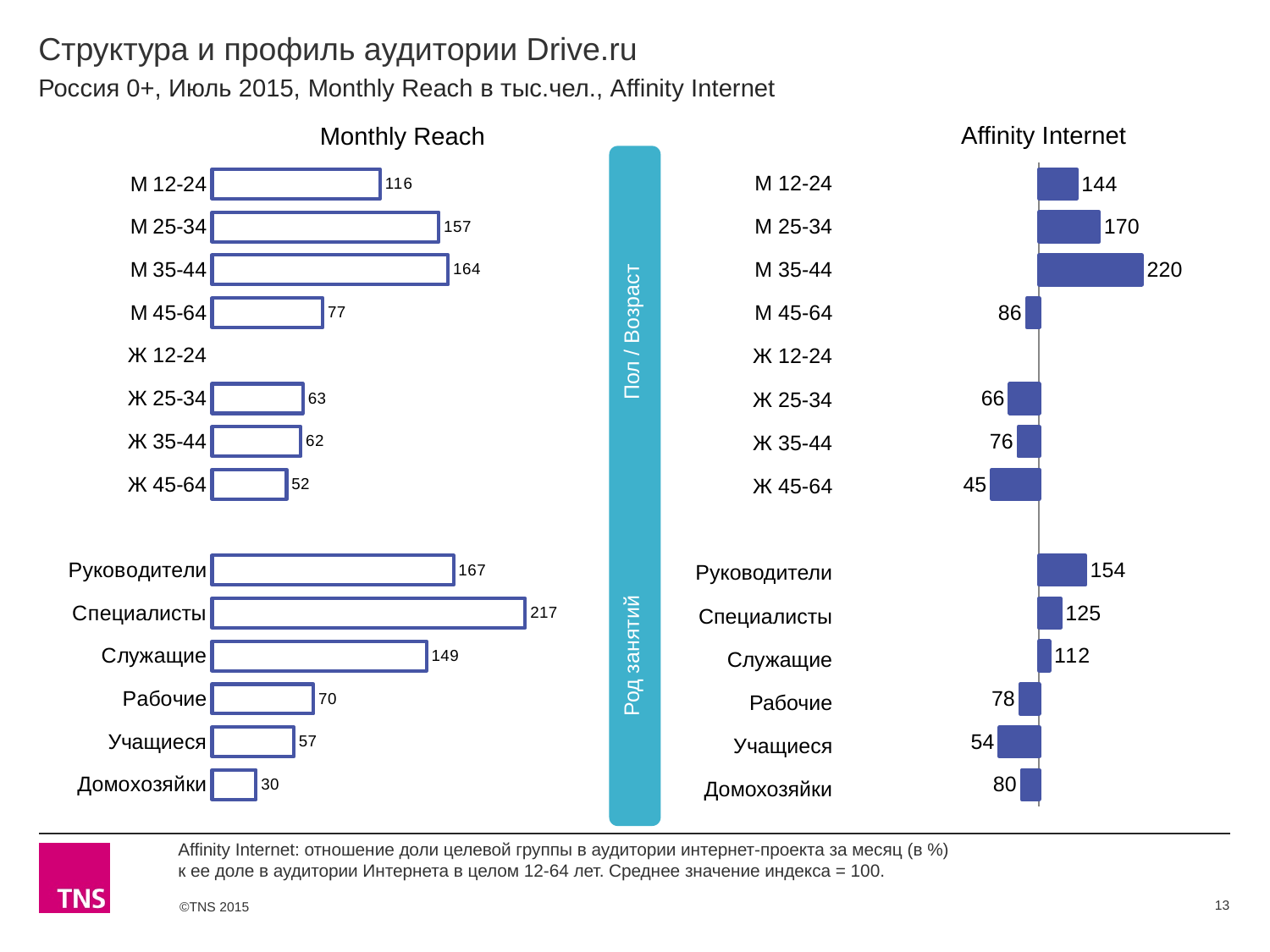
In the Monthly Reach chart, what is the difference between the values for М 25-34 and М 45-64? 80 In the Monthly Reach chart, what is the value for М 35-44? 164 In the Monthly Reach chart, which category has the lowest value? Домохозяйки In the Monthly Reach chart, what is the value for Специалисты? 217 In the Monthly Reach chart, which category has the highest value? Специалисты In the Affinity Internet chart, what is the value for Ж 45-64? 45 In the Affinity Internet chart, which is larger, the value for Служащие or the value for Рабочие? Служащие In the Affinity Internet chart, what is the value for Руководители? 154 In the Affinity Internet chart, which category has the lowest value? Ж 45-64 In the Affinity Internet chart, which category has the highest value? М 35-44 What kind of chart is the Monthly Reach chart? Bar chart In the Affinity Internet chart, what is the difference between the values for М 35-44 and М 12-24? 76